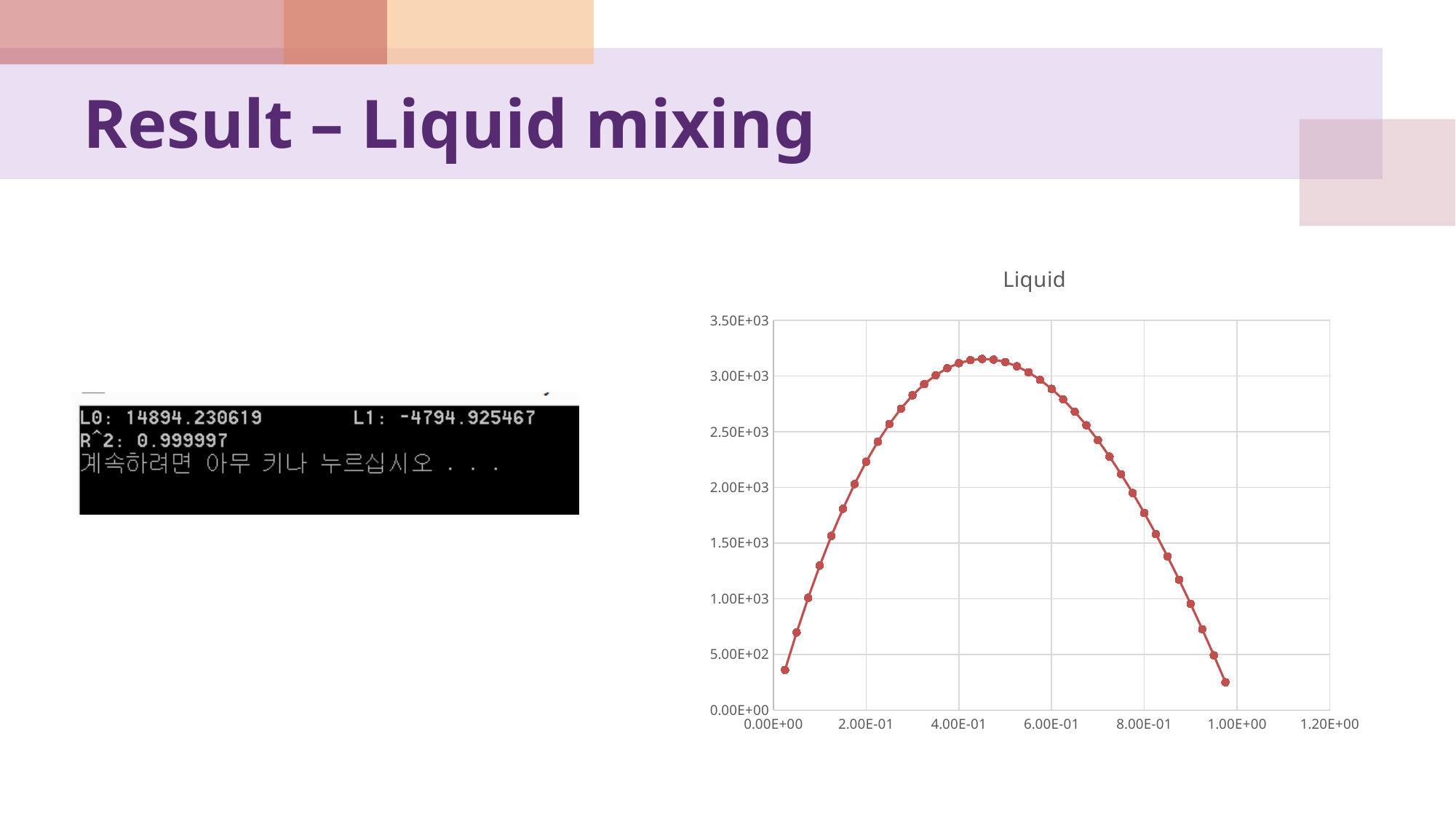
Is the value of the first plotted point (near x = 0.00E+00) greater or less than 5.00E+02? less Is the peak value of the curve greater or less than 3.00E+03? greater Is the value at x = 8.00E-01 greater or less than 2.00E+03? less Between which two x-axis tick labels does the peak of the curve occur? 4.00E-01 and 6.00E-01 Which is larger: the value at x = 2.00E-01 or the value at x = 8.00E-01? the value at x = 2.00E-01 How do the plotted values change as x increases from 0.00E+00 to 1.00E+00? rise to a peak then fall What is the highest tick label shown on the y axis? 3.50E+03 What is the title of the chart? Liquid What kind of chart is shown on the slide? line chart with markers